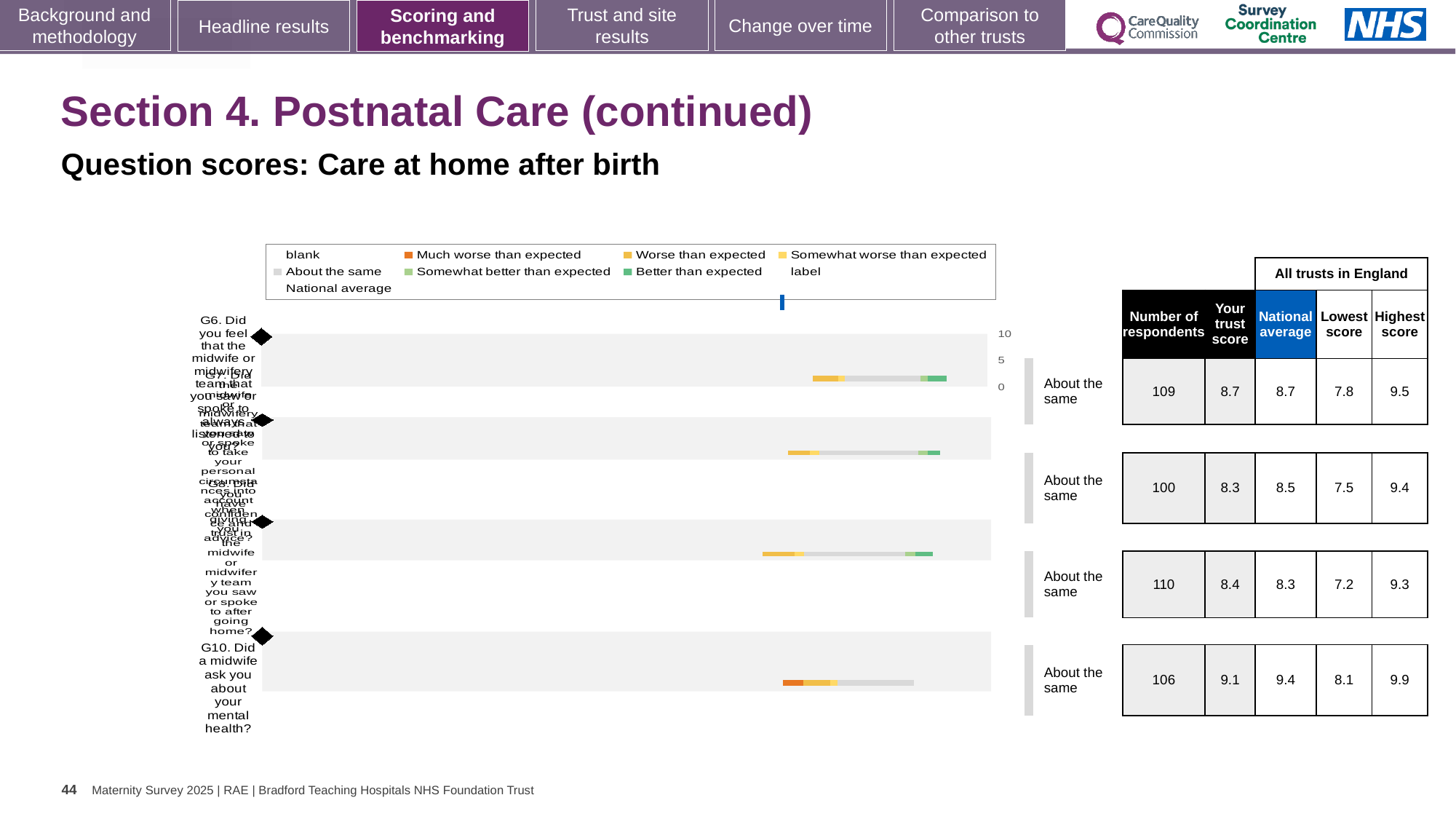
For G10 (the last row), what is the difference between the national average and the trust score? 0.3 For the third row, which is larger: the trust score or the national average? the trust score (8.4) Which row has the highest 'Your trust score' in the table? G10 (9.1) In the table, what is the national average for G10 (the last row)? 9.4 What kind of chart is shown on the slide? bar chart What is the benchmark label shown next to the bar for G10 (Did a midwife ask you about your mental health?)? About the same In the table, what is the highest score across all trusts in England for G10 (the last row)? 9.9 In the table, what is the lowest score across all trusts in England for the second row? 7.5 In the table, what is the 'Your trust score' for G6 (the first row)? 8.7 Which row has the lowest number of respondents in the table? the second row (100) In the table, what is the number of respondents for G10 (Did a midwife ask you about your mental health?)? 106 How many question rows (bars) are plotted in the chart? 4